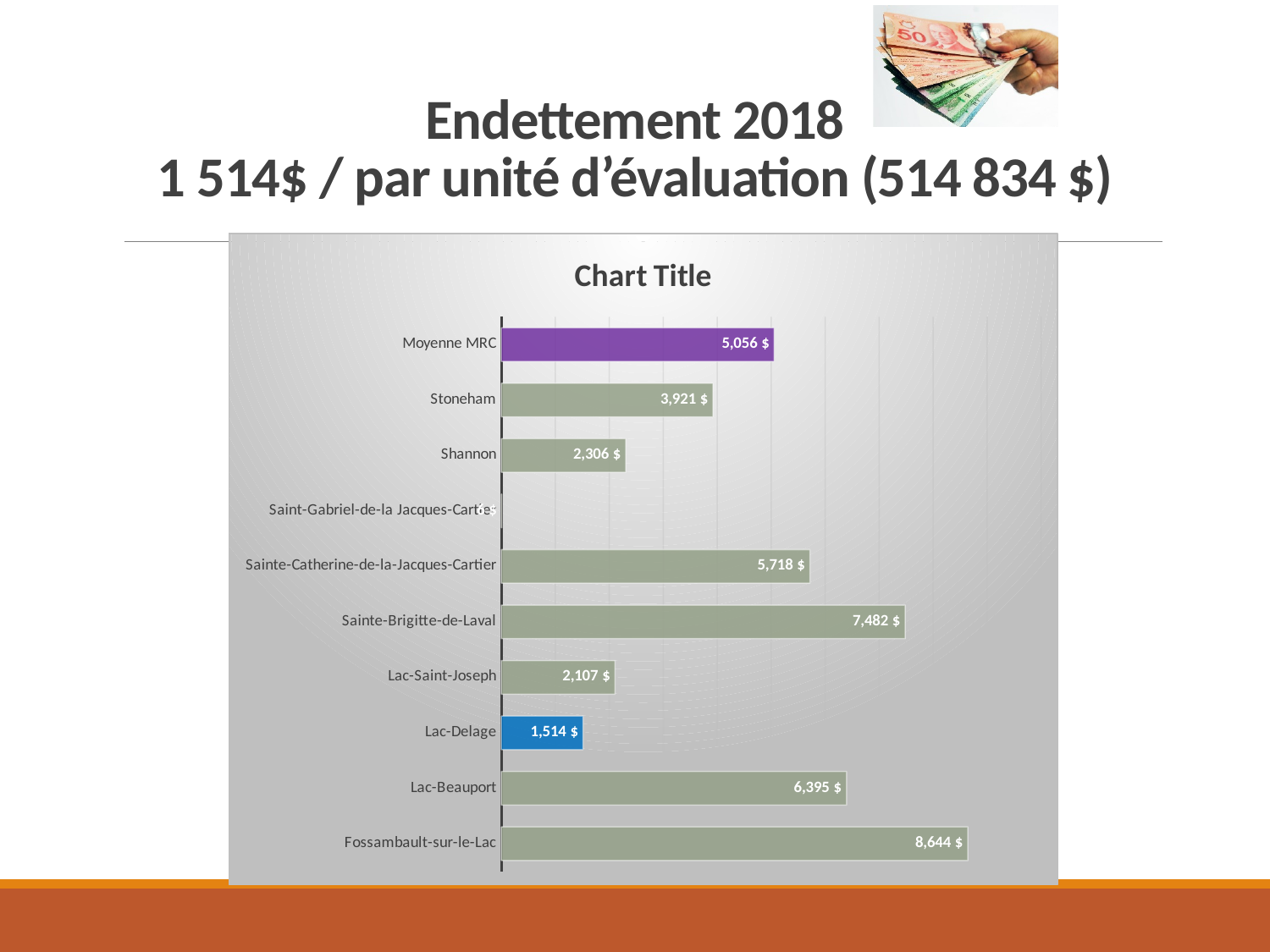
What is the difference between the values for Fossambault-sur-le-Lac and Lac-Delage? 7,130 $ What is the difference between the values for Sainte-Brigitte-de-Laval and Lac-Beauport? 1,087 $ What colour is the bar for Lac-Delage? Blue What is the value for Fossambault-sur-le-Lac? 8,644 $ What is the value for Sainte-Brigitte-de-Laval? 7,482 $ Which category has the highest value? Fossambault-sur-le-Lac How many categories are shown on the chart? 10 Which is larger, the value for Stoneham or the value for Shannon? Stoneham What is the value for Lac-Saint-Joseph? 2,107 $ What is the value for Moyenne MRC? 5,056 $ What is the value for Lac-Delage? 1,514 $ What kind of chart is shown on the slide? Bar chart